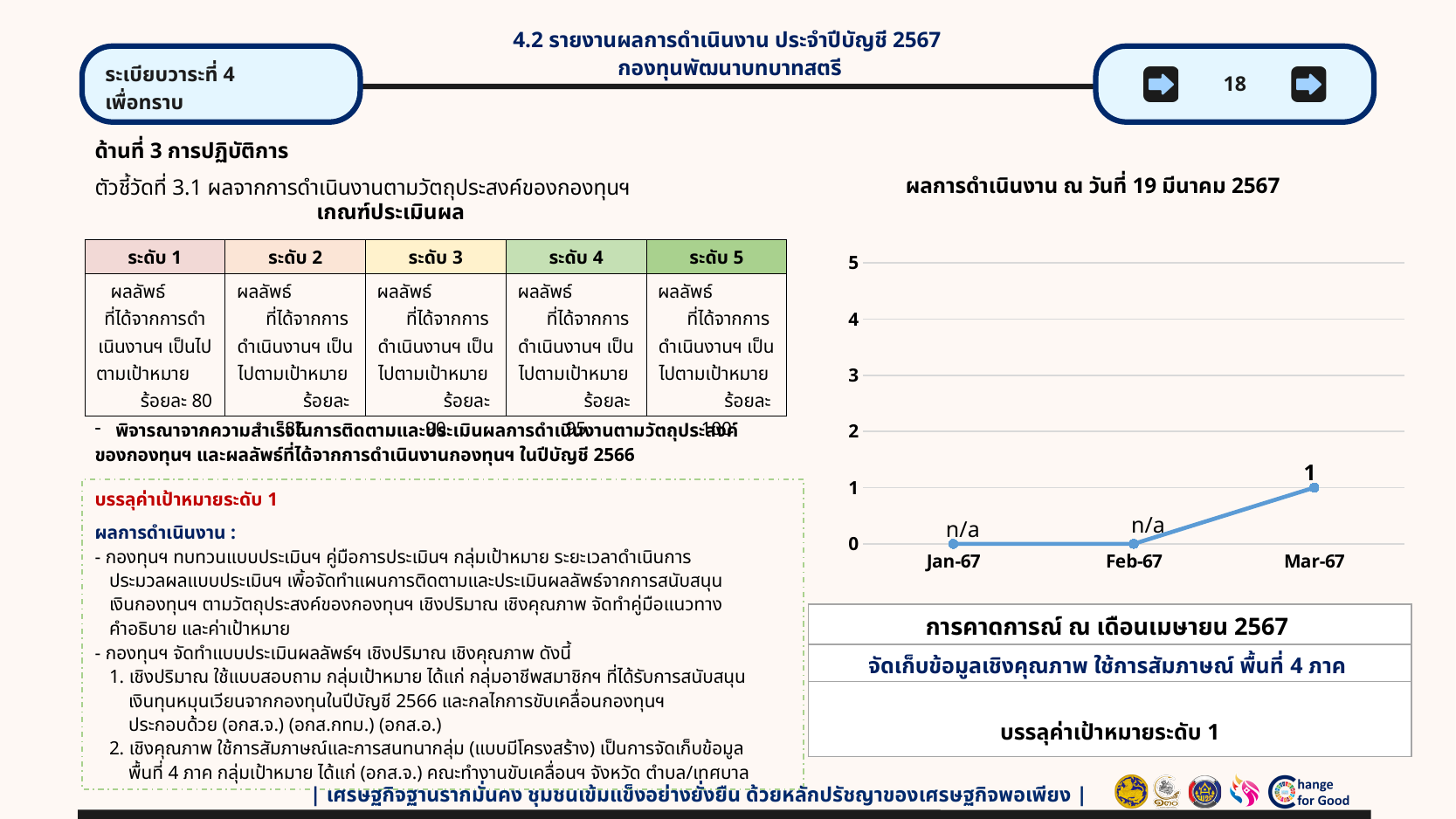
What is the highest value shown on the y axis? 5 What data label is shown for Feb-67? n/a What is the value plotted for Mar-67? 1 Is the value for Mar-67 greater or less than 2? less Which is larger, the value for Mar-67 or the value for Feb-67? Mar-67 What type of chart is shown on the slide? line chart Which month has the highest plotted value? Mar-67 How many points (months) are plotted on the x axis? 3 Does the line rise or fall from Feb-67 to Mar-67? rise What data label is shown for Jan-67? n/a What is the title of the chart? ผลการดำเนินงาน ณ วันที่ 19 มีนาคม 2567